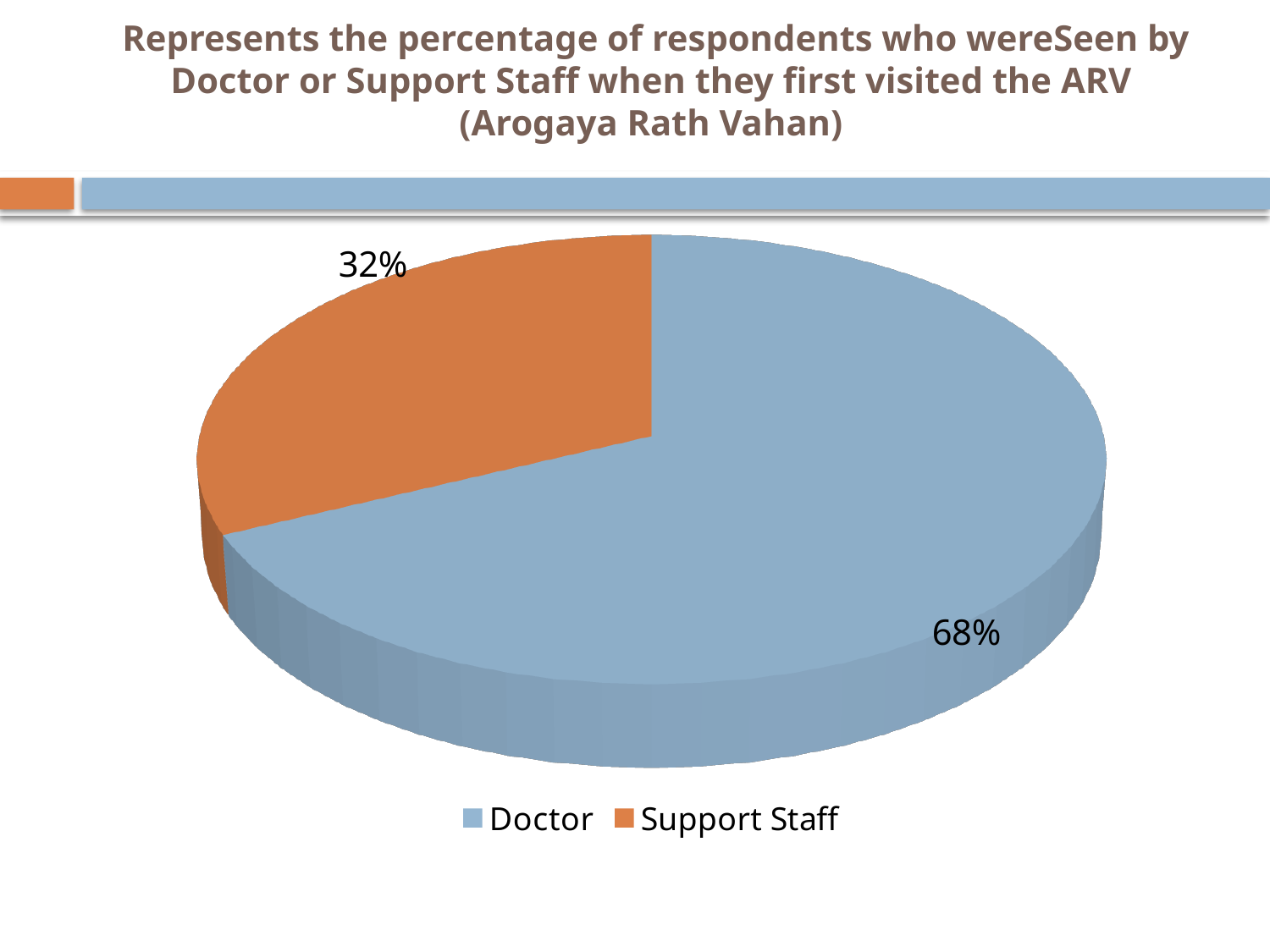
How many slices does the pie chart have? 2 What kind of chart is shown on the slide? Pie chart What colour is the Support Staff slice in the pie chart? Orange Which is larger, the Doctor slice or the Support Staff slice? Doctor Which category has the largest share of the pie? Doctor What percentage of respondents were seen by a Doctor? 68% What share of the pie does the Support Staff slice represent? 32% Which category has the smallest share of the pie? Support Staff What percentage of respondents were seen by Support Staff? 32% What colour is the Doctor slice in the pie chart? Blue How many entries does the legend list? 2 What is the difference in percentage points between the Doctor and Support Staff slices? 36